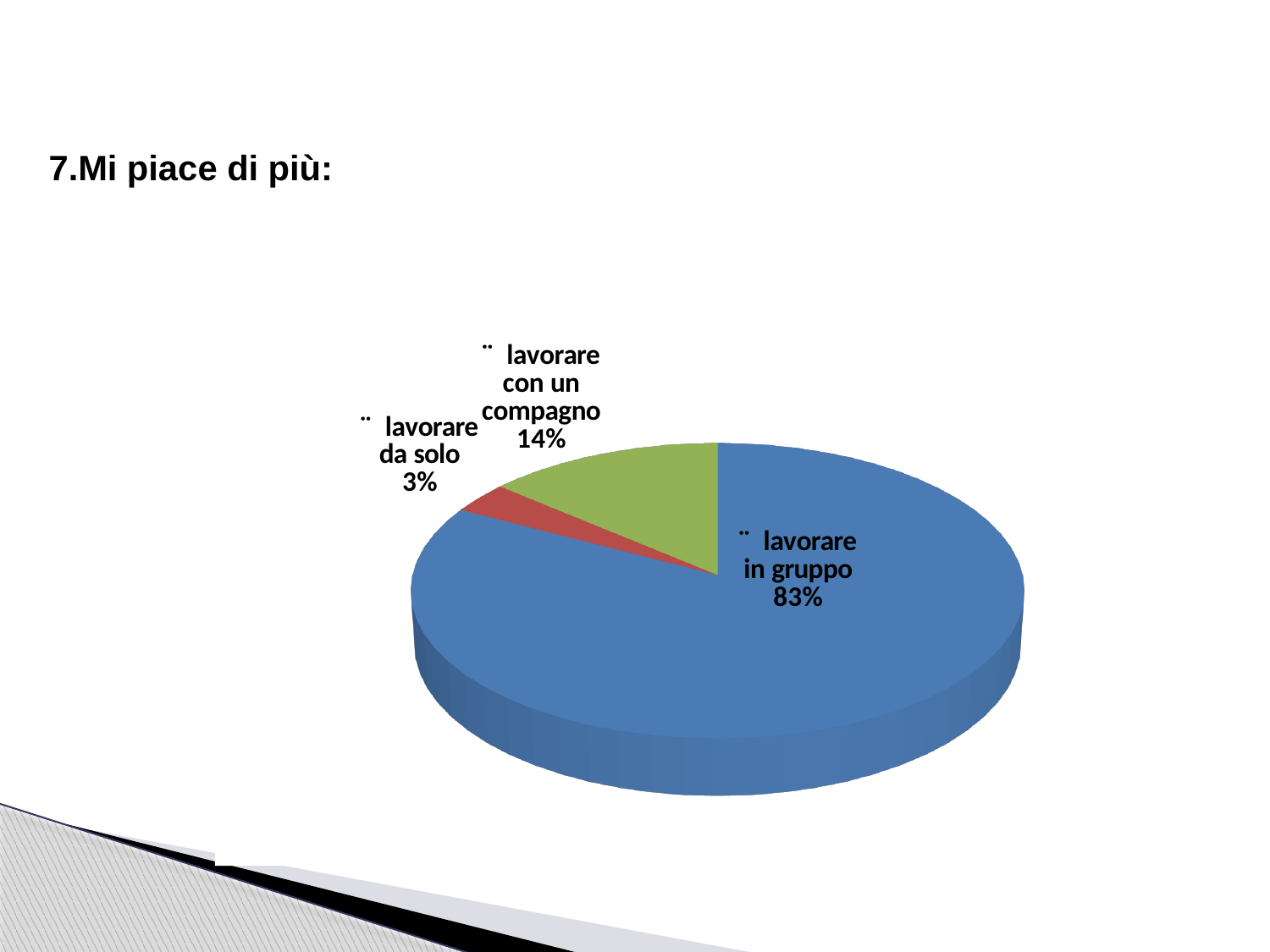
What is the title of the slide above the pie chart? 7.Mi piace di più: Which is larger, the share for 'lavorare con un compagno' or for 'lavorare da solo'? lavorare con un compagno What percentage of the pie is 'lavorare con un compagno'? 14% What is the difference in percentage points between 'lavorare con un compagno' and 'lavorare da solo'? 11 How many slices does the pie chart have? 3 What percentage of the pie is 'lavorare da solo'? 3% What kind of chart is shown on the slide? pie chart What is the difference in percentage points between 'lavorare in gruppo' and 'lavorare con un compagno'? 69 Which slice of the pie is the largest? lavorare in gruppo What colour is the 'lavorare in gruppo' slice? blue What percentage of the pie is 'lavorare in gruppo'? 83% Which slice of the pie is the smallest? lavorare da solo